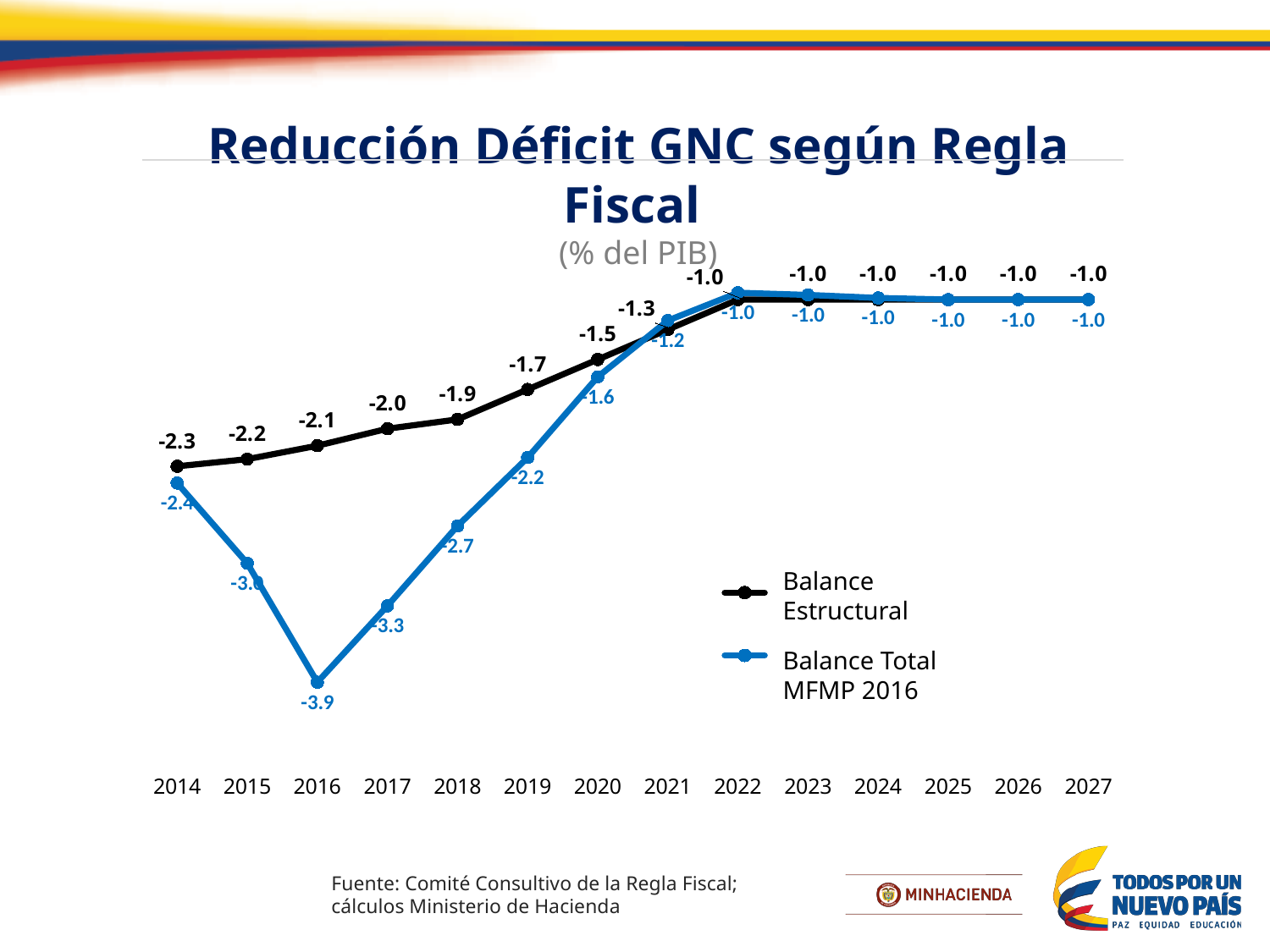
What is the value of Balance Total MFMP 2016 in 2016? -3.9 In which year does Balance Total MFMP 2016 reach its lowest value? 2016 What is the value of Balance Estructural in 2019? -1.7 How many series does the legend list? 2 What is the value of Balance Estructural in 2014? -2.3 What kind of chart is shown on the slide? line chart What is the value of Balance Total MFMP 2016 in 2021? -1.2 What unit is given in the chart subtitle? % del PIB How many years are shown on the x axis? 14 What is the difference between Balance Estructural and Balance Total MFMP 2016 in 2017? 1.3 In 2018, which series has the higher value, Balance Estructural or Balance Total MFMP 2016? Balance Estructural Does Balance Estructural rise or fall from 2014 to 2022? rise